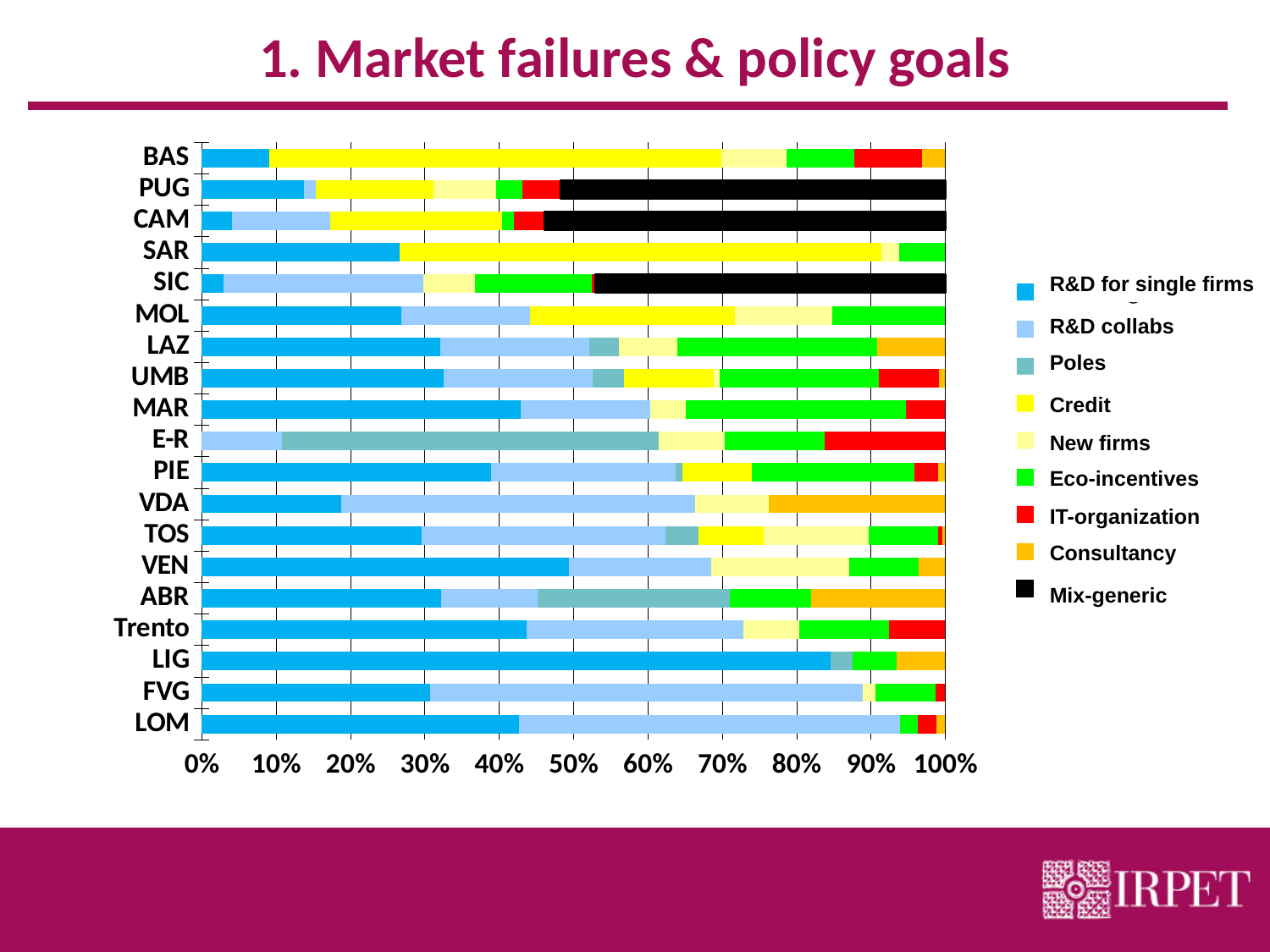
Is the R&D for single firms share for LIG greater or less than 80%? greater Which region has a larger Poles segment, E-R or LAZ? E-R How many series does the legend list? 9 Which series is shown in black in the legend? Mix-generic Is the R&D for single firms share for BAS greater or less than 10%? less Which region has the largest R&D for single firms segment? LIG Is the Credit share for BAS greater or less than 50%? greater Which region has a larger R&D for single firms segment, LIG or BAS? LIG How many regions (categories) are plotted on the chart? 19 What total does each stacked bar reach on the x axis? 100% What kind of chart is shown on the slide? Stacked bar chart